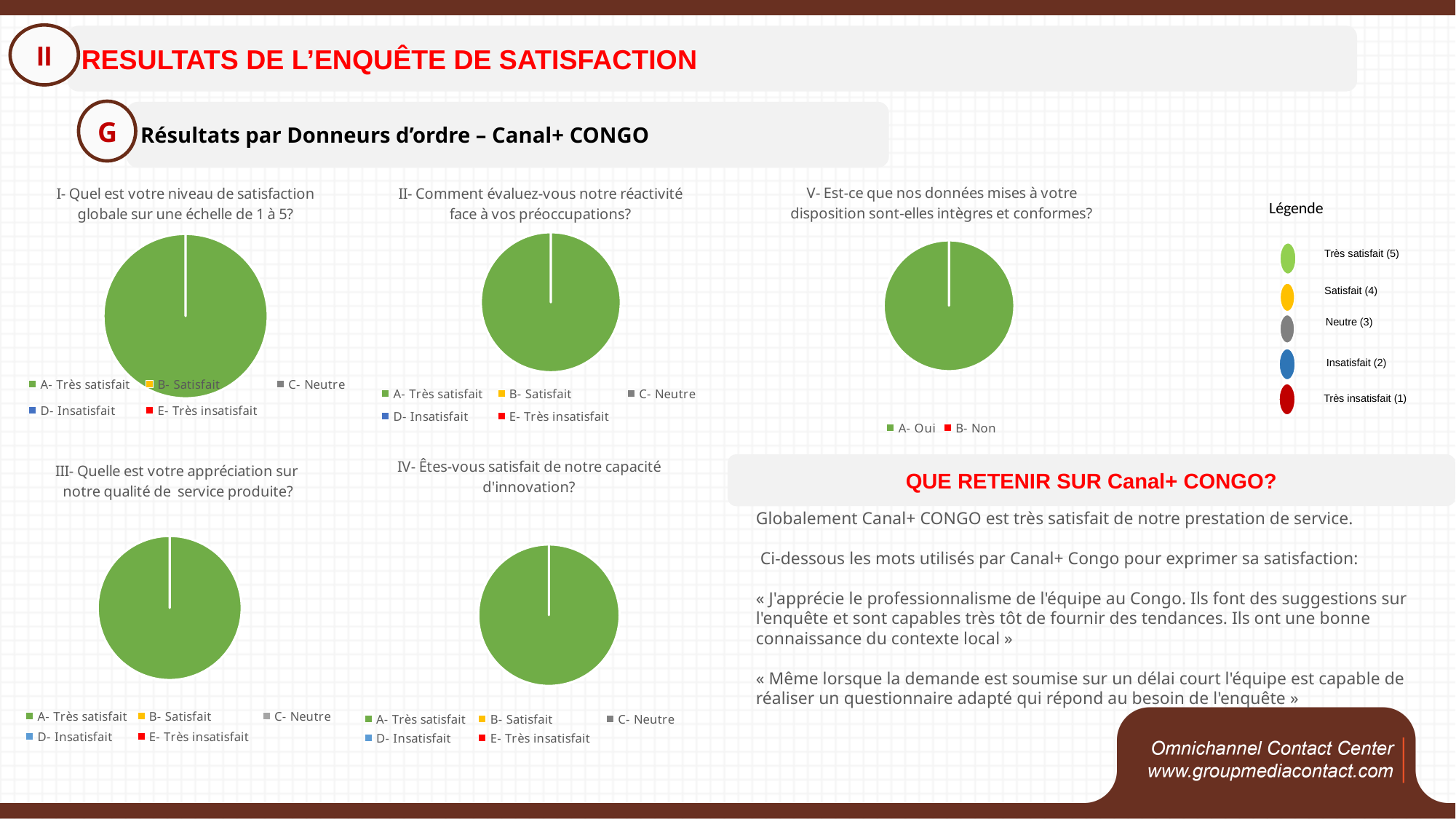
How many categories does the legend list for the chart on question II (réactivité face à vos préoccupations)? 5 What kind of chart is used for question I, 'Quel est votre niveau de satisfaction globale sur une échelle de 1 à 5?' Pie chart In the chart for question V (données intègres et conformes), which category makes up the largest share of the pie? A- Oui What colour represents 'A- Très satisfait' in the chart for question III (qualité de service produite)? Green How many categories does the legend list for the chart on question V (données intègres et conformes)? 2 In the chart for question III (qualité de service produite), which category makes up the largest share of the pie? A- Très satisfait In the chart for question I (satisfaction globale), which category makes up the largest share of the pie? A- Très satisfait How many pie charts are shown on the slide? 5 What are the two legend entries of the chart for question V (données intègres et conformes)? A- Oui and B- Non